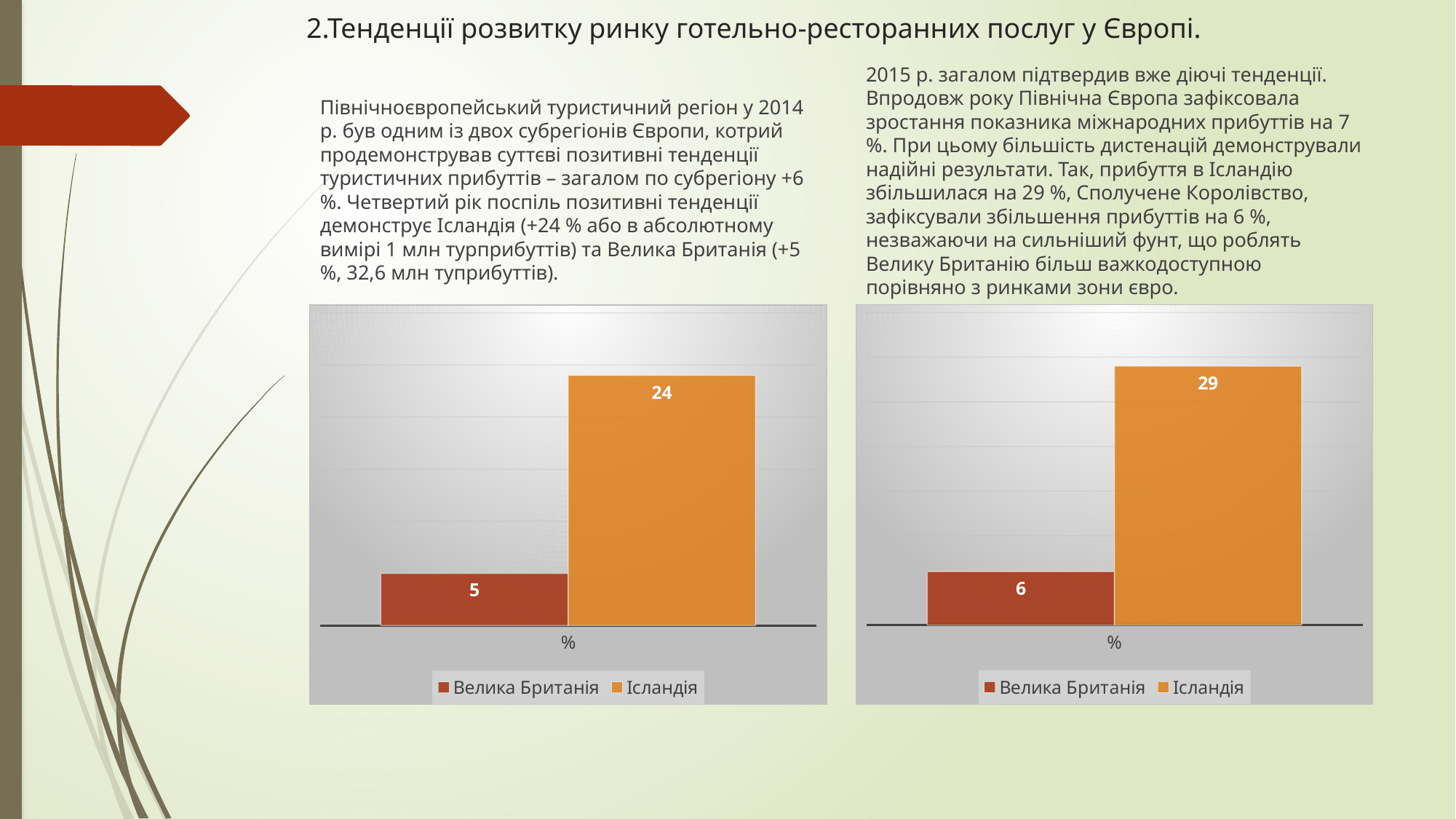
What is the x-axis category label shown under the bars in the left chart? % In the left chart, what is the value for Велика Британія? 5 In the right chart, is the value for Ісландія larger or smaller than the value for Велика Британія? larger In the right chart, which series has the lower value? Велика Британія How many series does the legend of the left chart list? 2 In the right chart, what is the value for Велика Британія? 6 What kind of chart is the right chart? bar chart In the right chart, what is the difference between the values for Ісландія and Велика Британія? 23 In the left chart, what is the value for Ісландія? 24 In the left chart, what is the difference between the values for Ісландія and Велика Британія? 19 In the left chart, which series has the higher value? Ісландія In the right chart, what is the value for Ісландія? 29